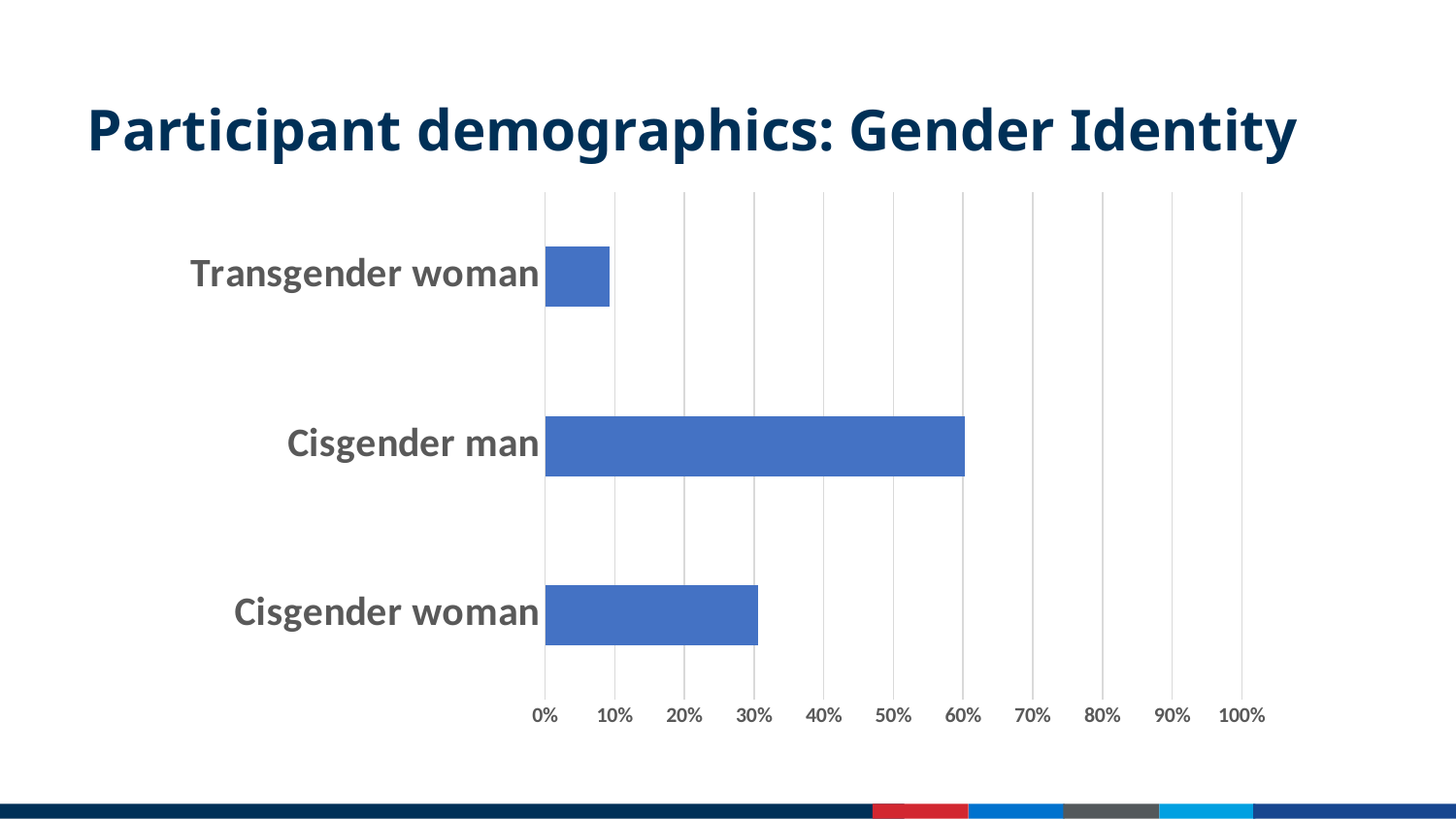
Which is larger, the value for Cisgender woman or the value for Transgender woman? Cisgender woman Which gender identity category has the highest value? Cisgender man Is the value for Transgender woman greater or less than 20%? less Is the value for Cisgender woman greater or less than 40%? less Which gender identity category has the lowest value? Transgender woman Is the value for Cisgender woman greater or less than 20%? greater What is the title of the chart on the slide? Participant demographics: Gender Identity What kind of chart is shown on the slide? bar chart What is the maximum value shown on the horizontal axis of the chart? 100% Which is larger, the value for Cisgender man or the value for Cisgender woman? Cisgender man How many gender identity categories are plotted in the chart? 3